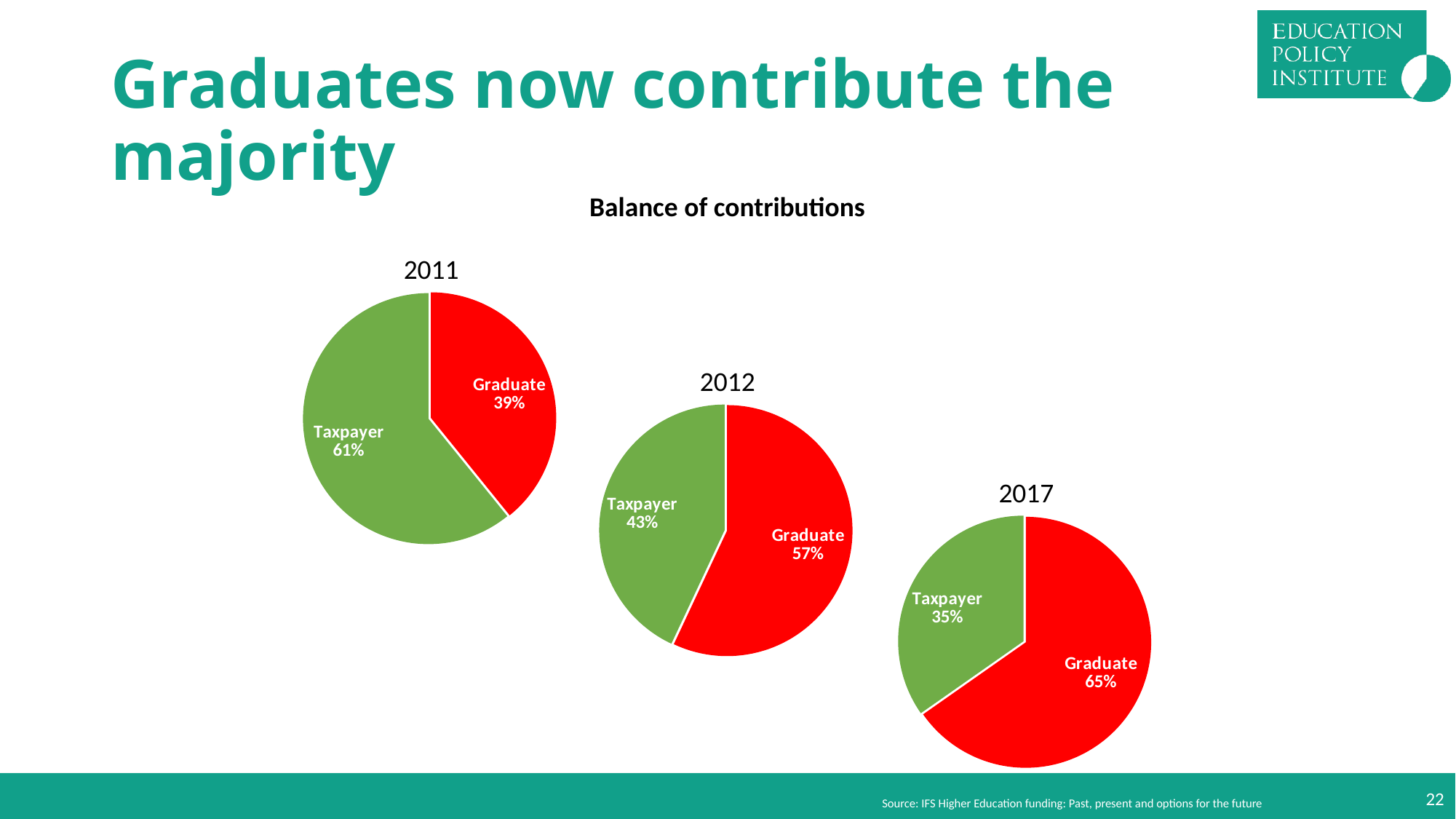
What kind of chart is used to show the balance of contributions for each year? Pie chart How many slices does the 2012 pie chart have? 2 In the 2012 pie chart, what is the Graduate share? 57% In the 2011 pie chart, what share of contributions comes from the Taxpayer? 61% Across the 2011, 2012 and 2017 pie charts, does the Graduate share rise or fall over time? Rise In the 2012 pie chart, which slice is the smallest? Taxpayer In the 2017 pie chart, what is the difference between the Graduate share and the Taxpayer share? 30 percentage points In the 2017 pie chart, which slice is larger, Graduate or Taxpayer? Graduate What is the title shown above the three pie charts? Balance of contributions In the 2011 pie chart, which slice is the largest? Taxpayer In the 2017 pie chart, what is the Taxpayer share? 35% In the 2011 pie chart, what share of contributions comes from Graduates? 39%